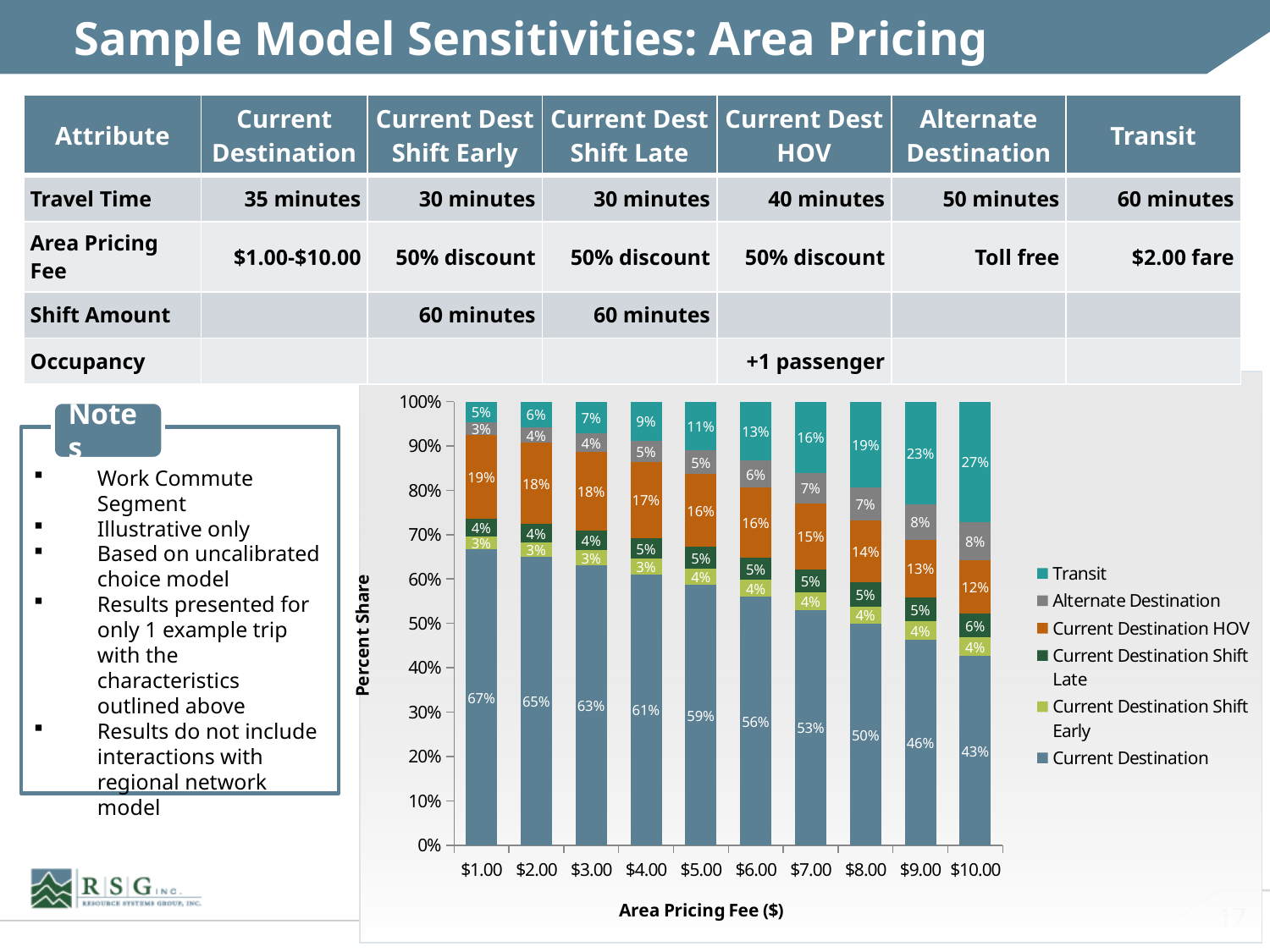
What is the Current Destination share at an area pricing fee of $1.00? 67% Does the Current Destination share rise or fall as the area pricing fee increases from $1.00 to $10.00? Fall How many area pricing fee levels are shown on the x axis? 10 At which area pricing fee is the Current Destination share lowest? $10.00 What is the Current Destination HOV share at an area pricing fee of $5.00? 16% What is the Alternate Destination share at an area pricing fee of $7.00? 7% What is the difference between the Current Destination share at $1.00 and at $10.00? 24% What kind of chart is shown on the slide? Stacked bar chart At which area pricing fee is the Transit share highest? $10.00 What is the Transit share at an area pricing fee of $10.00? 27% How many series does the legend list? 6 Which is larger at an area pricing fee of $8.00: the Transit share or the Current Destination HOV share? Transit